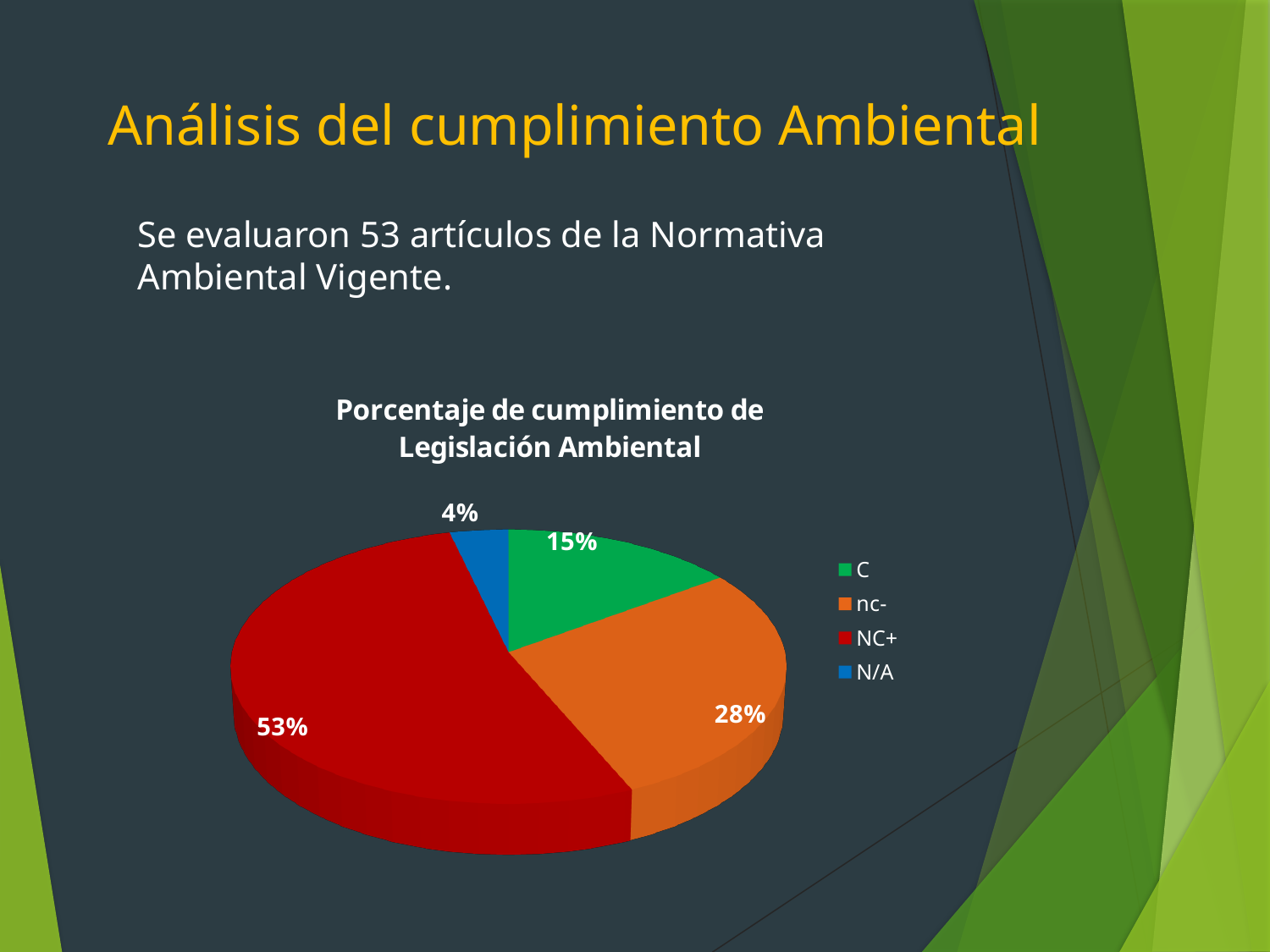
What percentage does the N/A slice represent? 4% Which is larger, the C slice or the nc- slice? nc- What type of chart is shown on the slide? Pie chart What is the difference in percentage points between the NC+ and nc- slices? 25 What colour is the NC+ slice in the pie chart? Red What percentage does the NC+ slice represent? 53% What is the title of the chart? Porcentaje de cumplimiento de Legislación Ambiental Which category has the largest share of the pie? NC+ What percentage does the nc- slice represent? 28% Which category has the smallest share of the pie? N/A How many categories does the pie chart show? 4 What percentage does the C slice represent? 15%